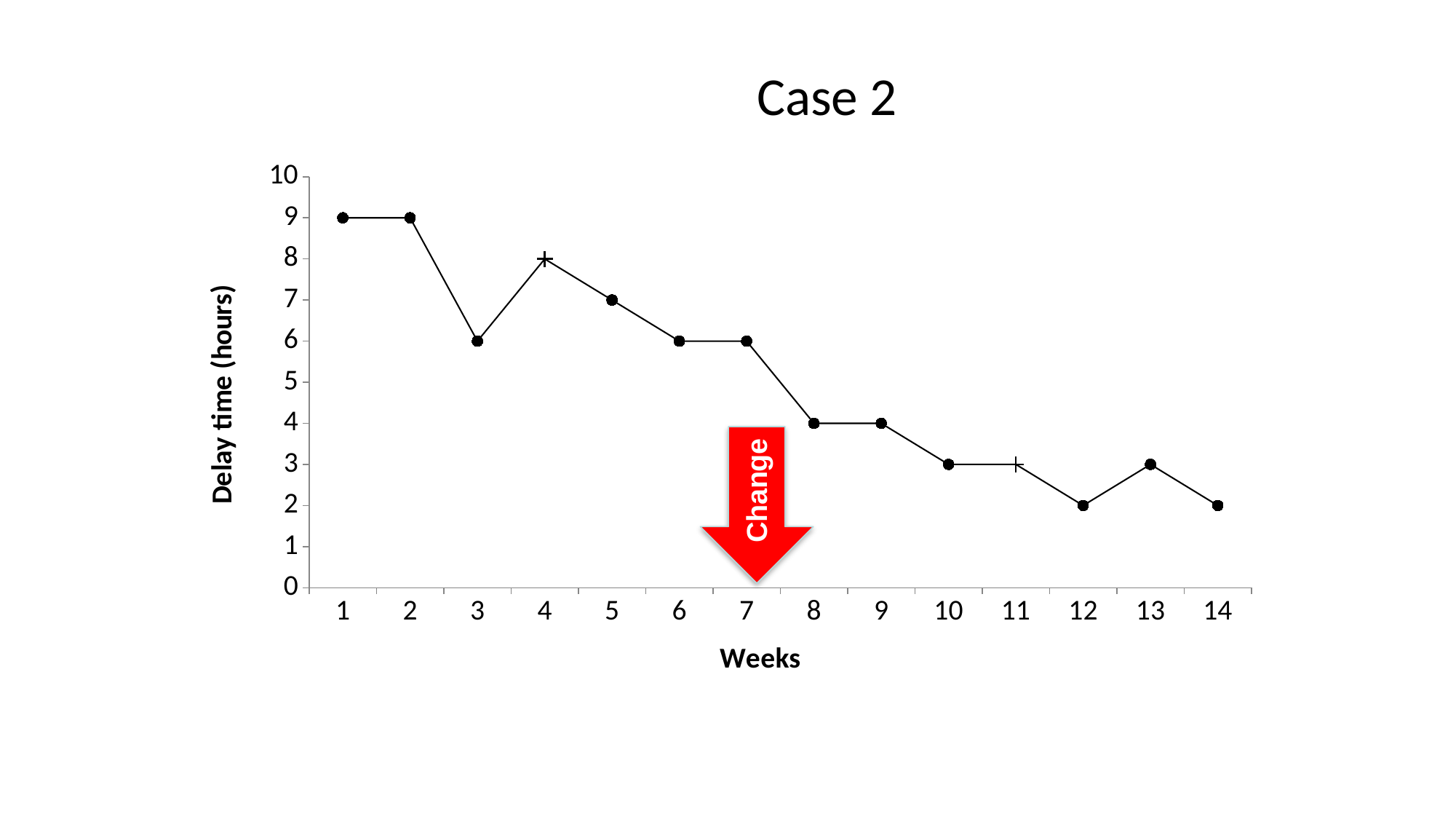
What is the delay time in week 8? 4 How many weeks are plotted on the chart? 14 What is the label on the y axis? Delay time (hours) What is the delay time in week 4? 8 Which has a higher delay time, week 5 or week 10? Week 5 What is the difference in delay time between week 2 and week 3? 3 What is the delay time in week 14? 2 Which week has the lowest delay time? Week 12 and week 14 (both 2) Does the delay time generally rise or fall over the weeks? fall What is the title of the chart? Case 2 What is the delay time in week 1? 9 What type of chart is shown on the slide? line chart